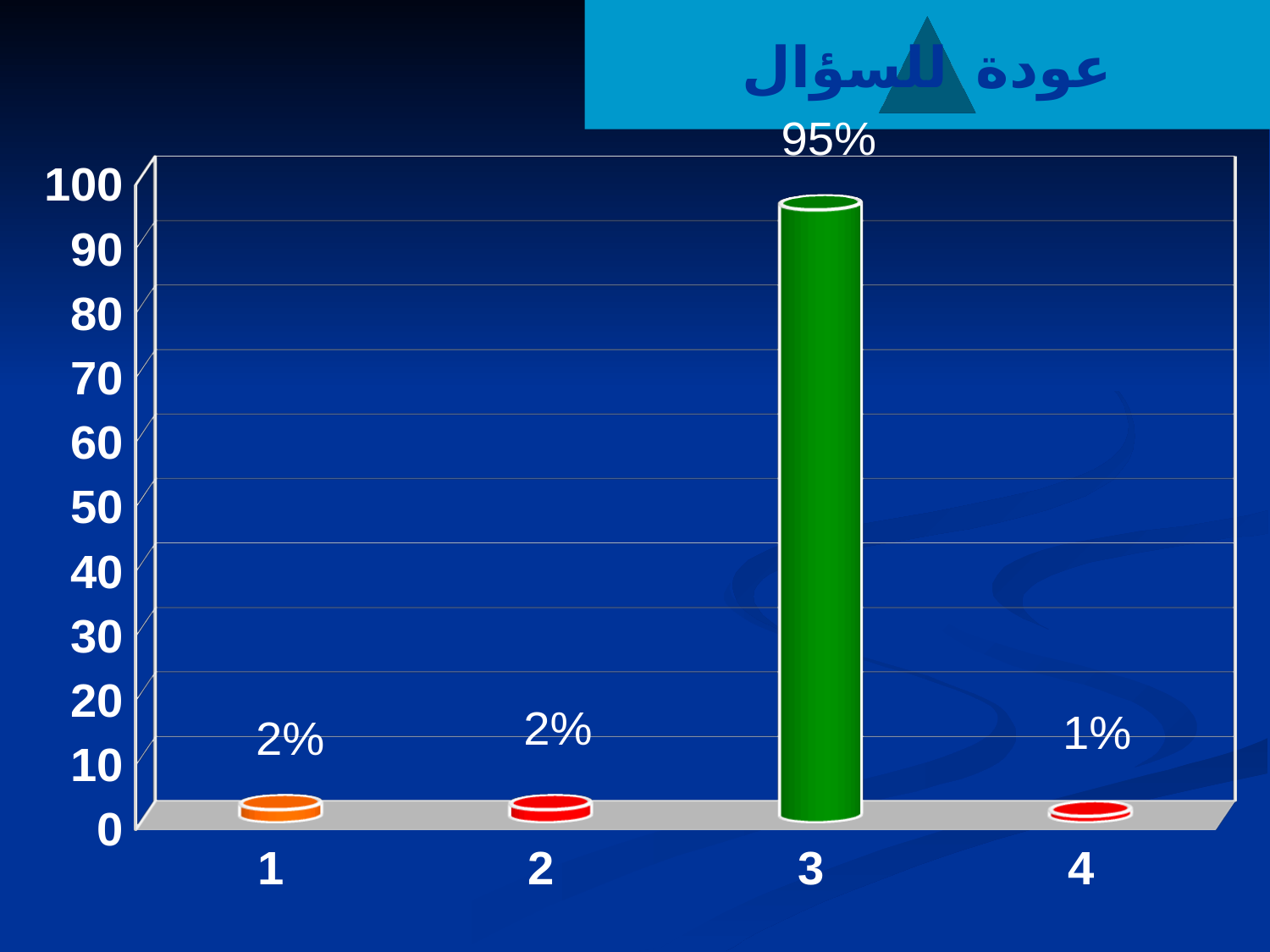
Which is larger, the value for category 3 or the value for category 1? 3 Which category has the lowest value? 4 What kind of chart is shown on the slide? bar chart What is the difference between the values for category 3 and category 2? 93% Which category has the highest value? 3 Is the value for category 3 greater or less than 90? greater What is the value for category 1? 2% What colour is the bar for category 3? green What is the value for category 3? 95% What is the difference between the values for category 1 and category 4? 1% How many categories are shown on the x axis? 4 What is the value for category 4? 1%